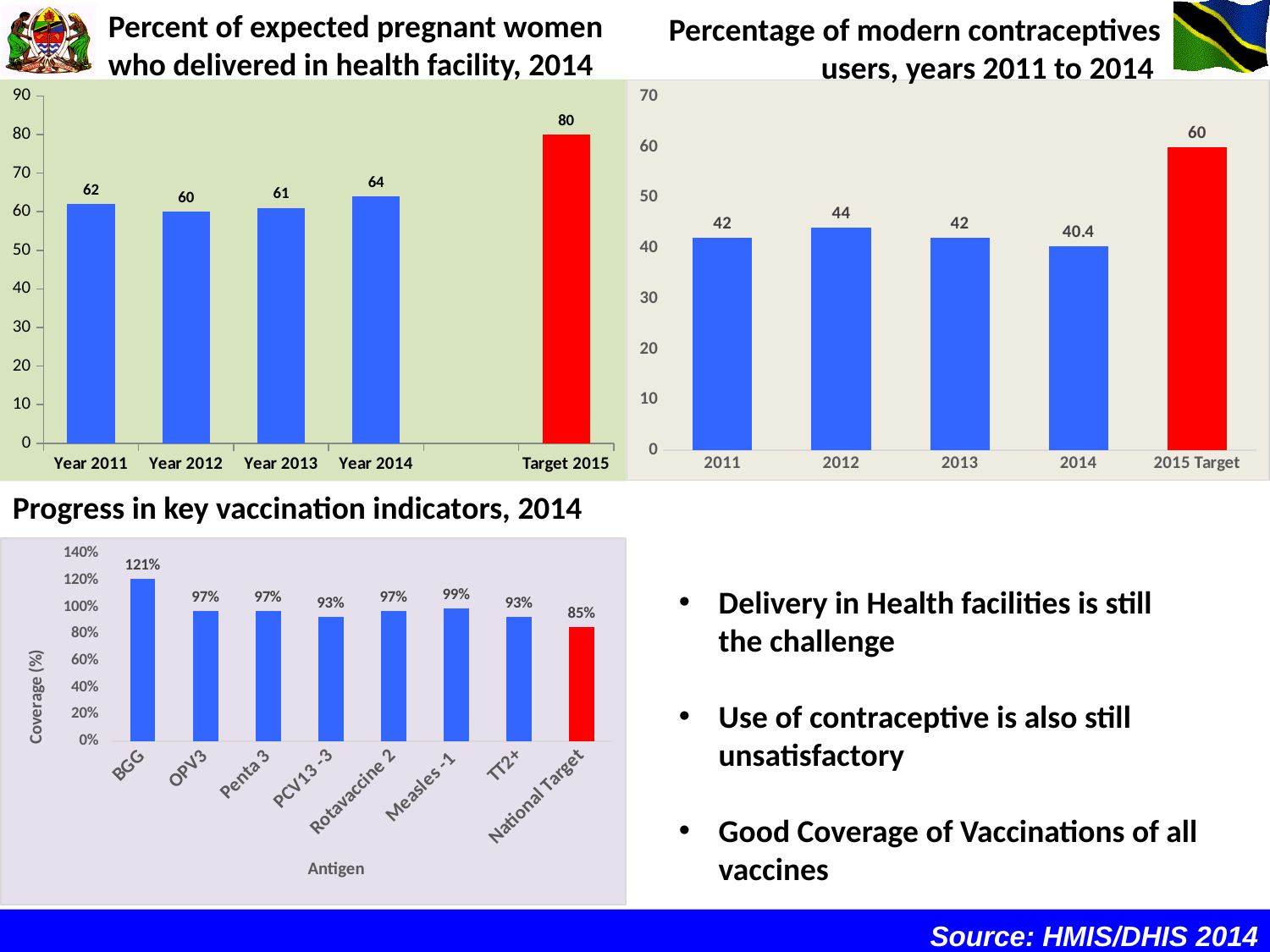
In the chart 'Percentage of modern contraceptives users, years 2011 to 2014', what is the value for 2014? 40.4 What kind of chart is 'Progress in key vaccination indicators, 2014'? bar chart In the chart 'Percent of expected pregnant women who delivered in health facility, 2014', what is the difference between the Target 2015 value and the Year 2014 value? 16 In the chart 'Percent of expected pregnant women who delivered in health facility, 2014', how many bars are plotted? 5 In the chart 'Percentage of modern contraceptives users, years 2011 to 2014', what is the difference between the 2015 Target and the 2014 value? 19.6 In the chart 'Percentage of modern contraceptives users, years 2011 to 2014', which year from 2011 to 2014 has the highest value? 2012 In the chart 'Percent of expected pregnant women who delivered in health facility, 2014', what is the value for Year 2014? 64 In the chart 'Progress in key vaccination indicators, 2014', what is the coverage for Measles -1? 99% In the chart 'Progress in key vaccination indicators, 2014', what is the value of the National Target bar? 85% In the chart 'Percent of expected pregnant women who delivered in health facility, 2014', which category has the lowest value? Year 2012 In the chart 'Progress in key vaccination indicators, 2014', what is the coverage for BGG? 121% In the chart 'Percentage of modern contraceptives users, years 2011 to 2014', is the value for 2012 larger or smaller than the value for 2013? larger